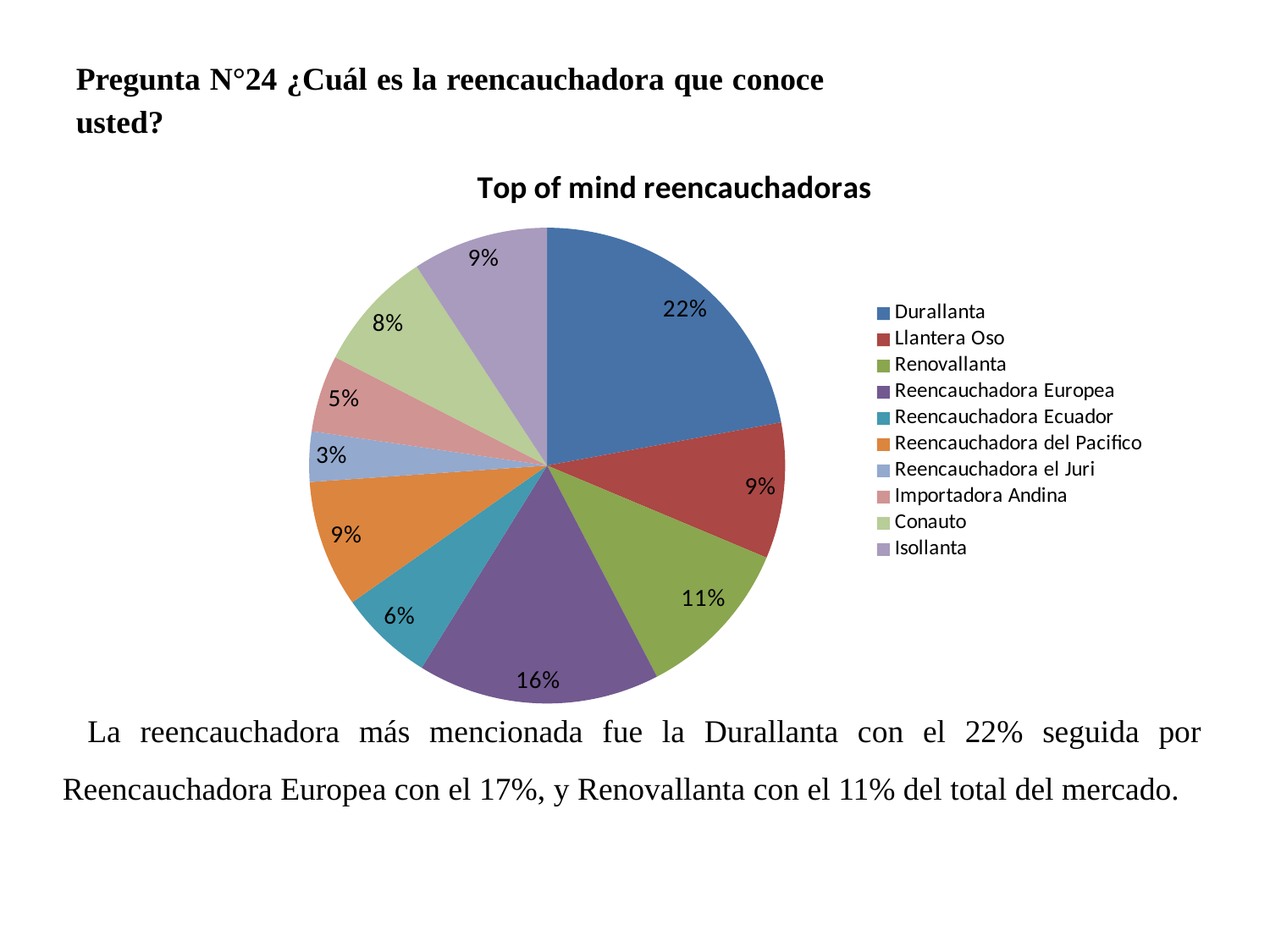
What kind of chart is shown on the slide? pie chart Which category has the largest slice of the pie? Durallanta How many categories does the legend list? 10 What share of the pie does Renovallanta have? 11% What share of the pie does Durallanta have? 22% What share of the pie does Reencauchadora Ecuador have? 6% Which category has the smallest slice of the pie? Reencauchadora el Juri What is the difference between the shares of Durallanta and Reencauchadora Europea? 6% What is the title of the pie chart? Top of mind reencauchadoras Which is larger, the share for Conauto or the share for Importadora Andina? Conauto